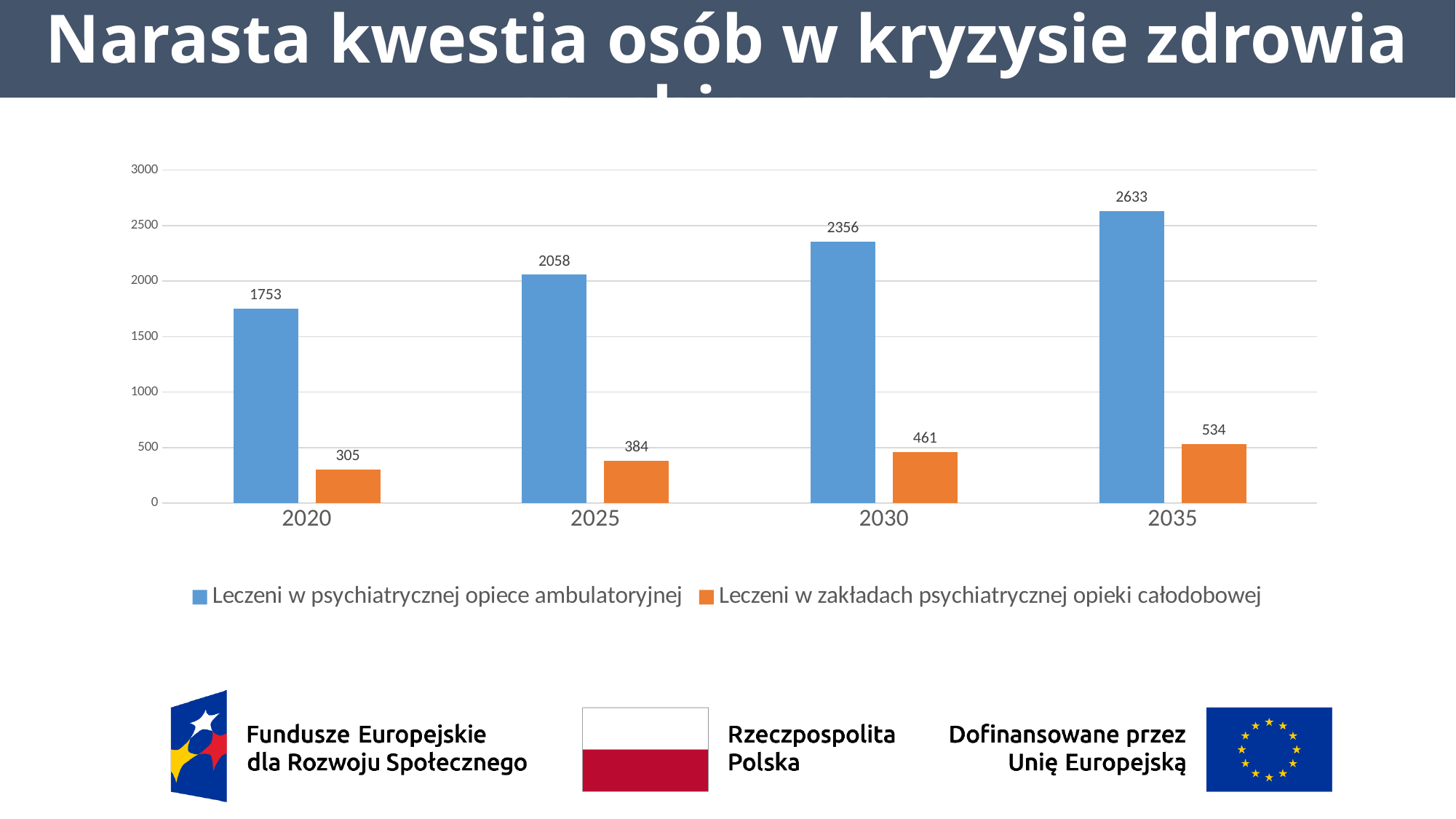
What is the value for 'Leczeni w zakładach psychiatrycznej opieki całodobowej' in 2035? 534 How many years are shown on the x axis? 4 What is the value for 'Leczeni w psychiatrycznej opiece ambulatoryjnej' in 2020? 1753 In which year is the value for 'Leczeni w zakładach psychiatrycznej opieki całodobowej' lowest? 2020 What kind of chart is shown on the slide? Bar chart What is the difference between the two series' values in 2025? 1674 What is the value for 'Leczeni w psychiatrycznej opiece ambulatoryjnej' in 2030? 2356 What is the difference between the 'Leczeni w psychiatrycznej opiece ambulatoryjnej' values for 2035 and 2020? 880 How many series does the legend list? 2 Which is larger in 2030: 'Leczeni w psychiatrycznej opiece ambulatoryjnej' or 'Leczeni w zakładach psychiatrycznej opieki całodobowej'? Leczeni w psychiatrycznej opiece ambulatoryjnej In which year is the value for 'Leczeni w psychiatrycznej opiece ambulatoryjnej' highest? 2035 Do the values for 'Leczeni w zakładach psychiatrycznej opieki całodobowej' rise or fall from 2020 to 2035? Rise